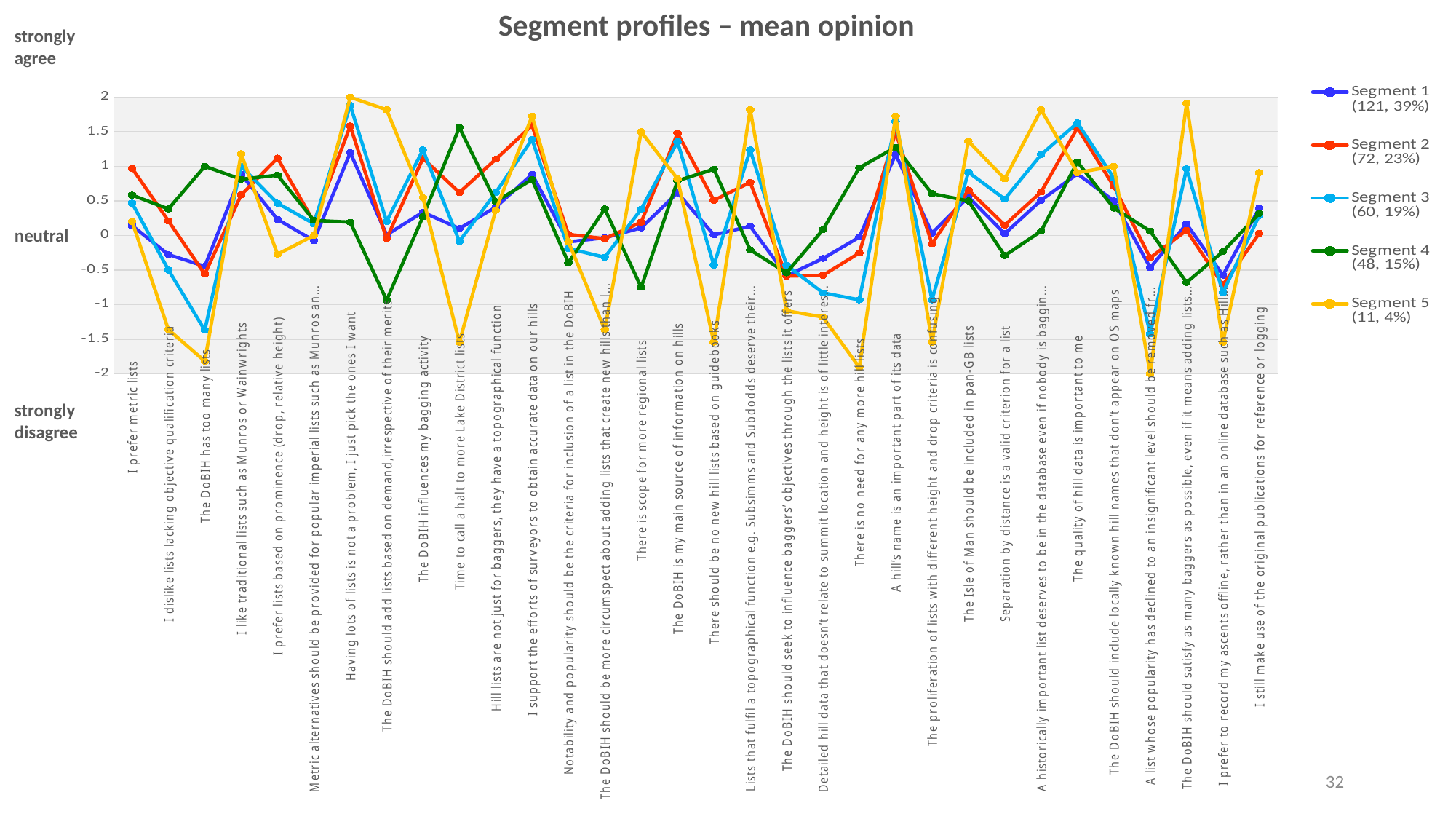
Which segment has the highest value for 'Time to call a halt to more Lake District lists'? Segment 4 What percentage is shown in the legend for Segment 1? 39% For 'There is no need for any more hill lists', which is larger: the value for Segment 4 or the value for Segment 5? Segment 4 Is the value for Segment 5 on 'The DoBIH should satisfy as many baggers as possible, even if it means adding lists...' greater or less than 1.5? greater Is the value for Segment 5 on 'There is no need for any more hill lists' greater or less than -1.5? less Which segment has the lowest value for 'The DoBIH has too many lists'? Segment 5 Is the value for Segment 4 on 'Time to call a halt to more Lake District lists' greater or less than 1? greater How many statements (categories) are plotted along the x axis? 32 What kind of chart is shown on the slide? line chart How many series does the legend list? 5 What is the title of the chart? Segment profiles – mean opinion